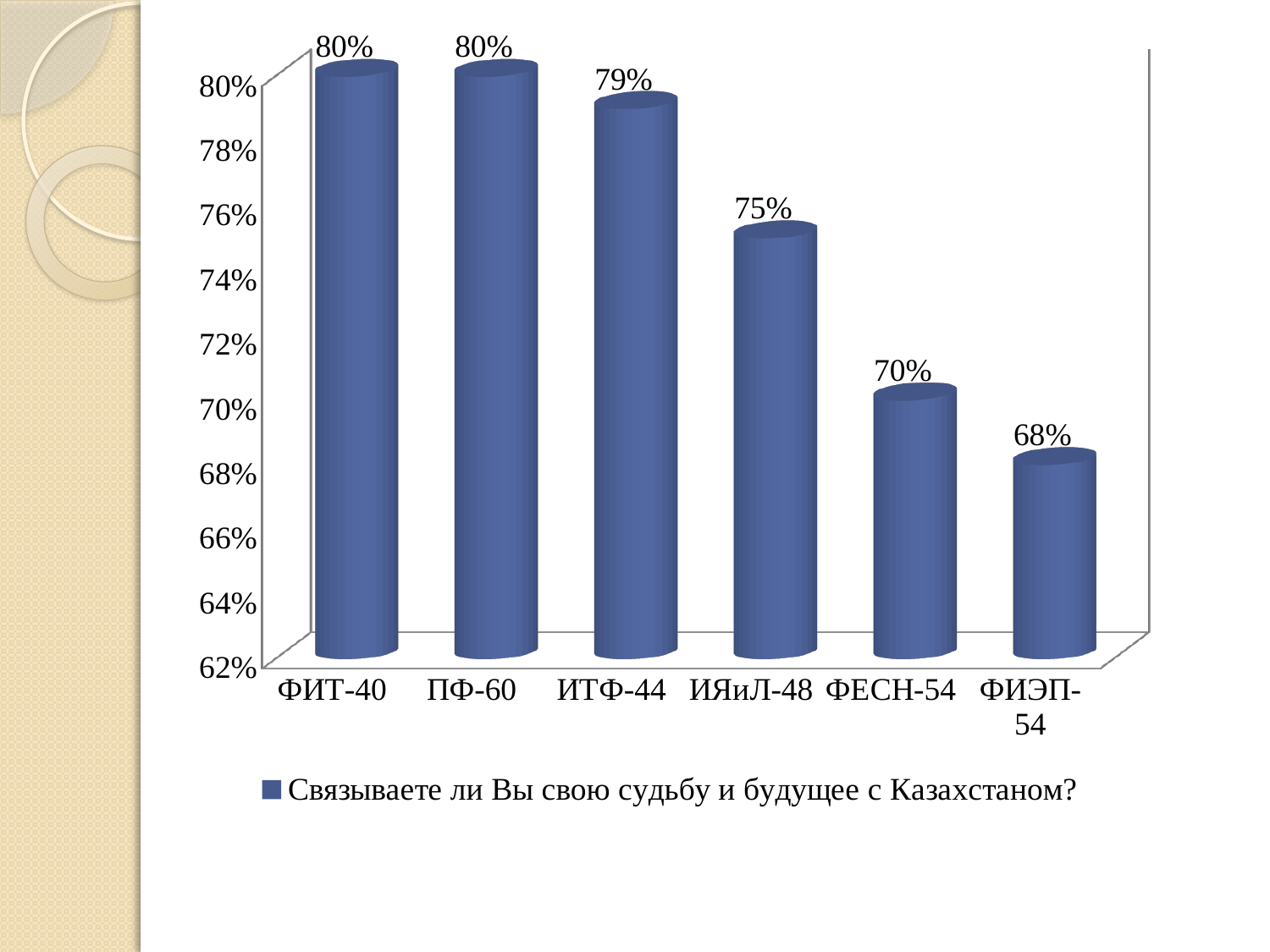
What kind of chart is shown on the slide? bar chart Is the value for ФИЭП-54 greater or less than 70%? less How many series does the legend list? 1 What is the difference between the values for ИЯиЛ-48 and ФЕСН-54? 5% What is the value for ФЕСН-54? 70% Which is larger, the value for ИТФ-44 or the value for ИЯиЛ-48? ИТФ-44 What is the value for ИЯиЛ-48? 75% What is the value for ИТФ-44? 79% Which category has the lowest value? ФИЭП-54 How many categories are shown on the x axis? 6 Do the values rise or fall from left to right along the x axis? fall What is the difference between the values for ФИТ-40 and ФИЭП-54? 12%